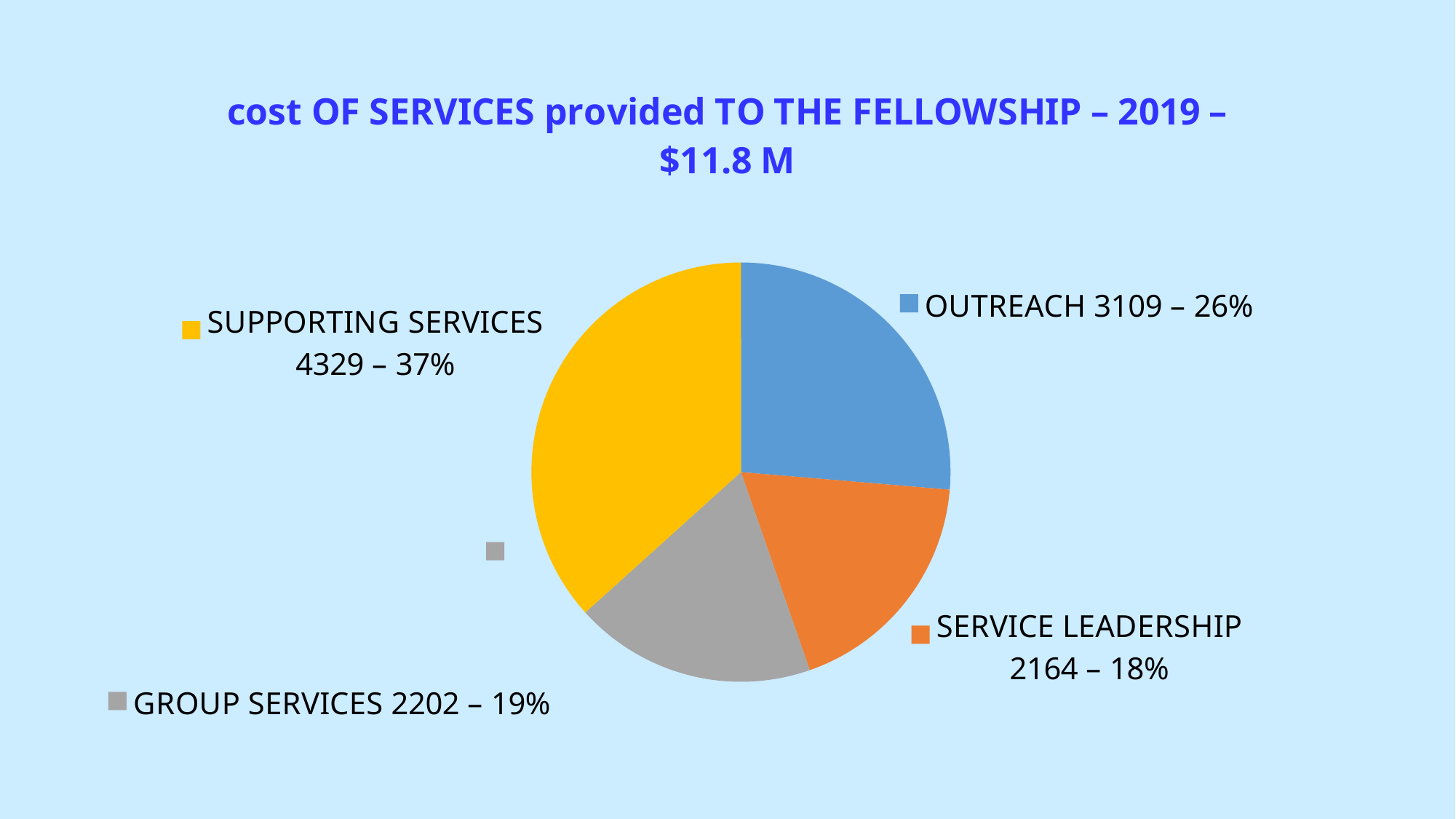
Which category has the smallest slice of the pie? SERVICE LEADERSHIP What is the value shown for SUPPORTING SERVICES? 4329 What total amount is stated in the chart title? $11.8 M What kind of chart is shown on the slide? pie chart How many slices does the pie chart have? 4 What percentage share of the pie does SERVICE LEADERSHIP have? 18% What is the value shown for GROUP SERVICES? 2202 Which category has the largest slice of the pie? SUPPORTING SERVICES Which is larger, the value for OUTREACH or the value for SERVICE LEADERSHIP? OUTREACH What is the difference between the values for SUPPORTING SERVICES and OUTREACH? 1220 What is the value shown for OUTREACH? 3109 What percentage share of the pie does SUPPORTING SERVICES have? 37%